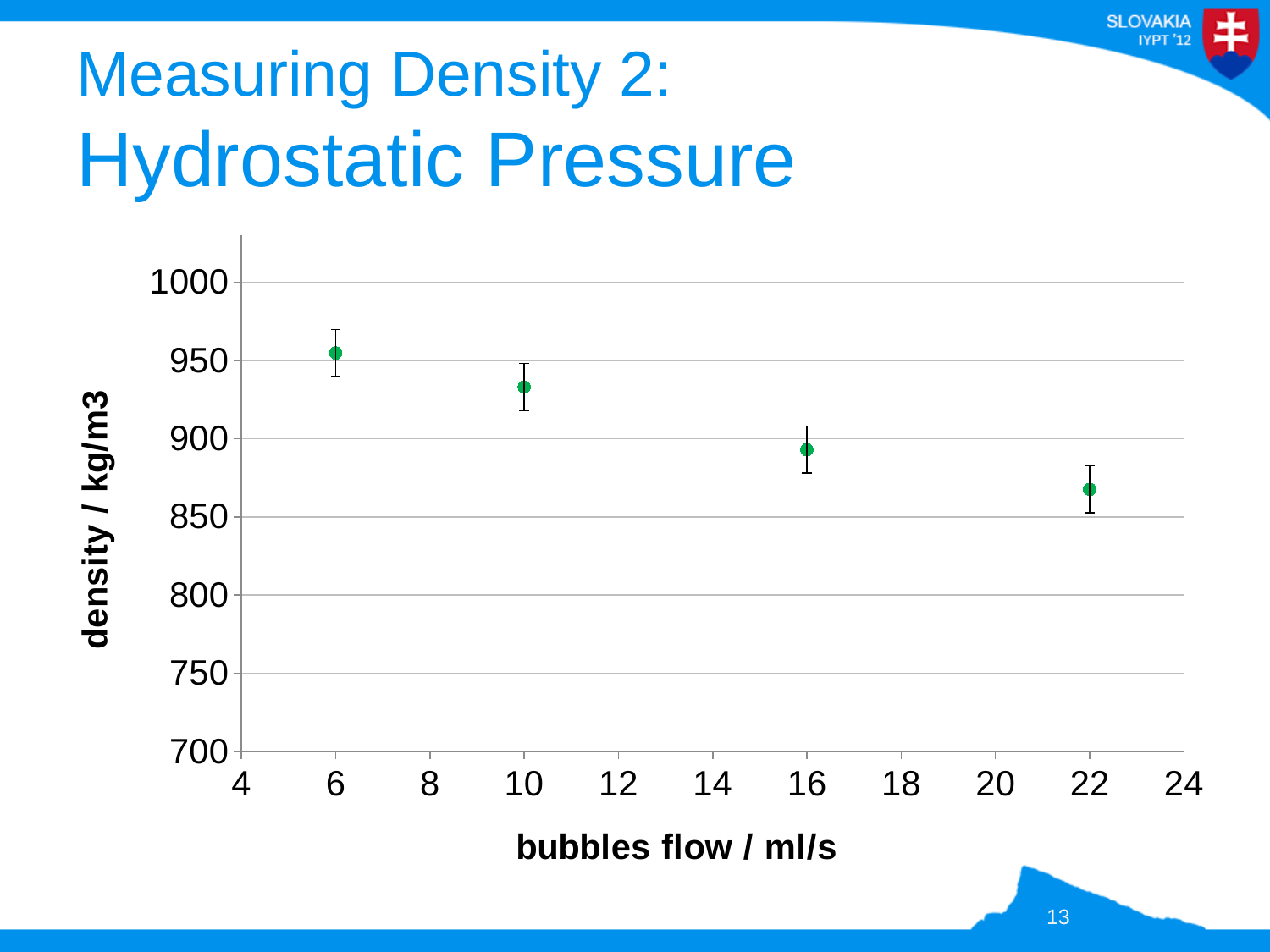
Is the density at a bubbles flow of 6 ml/s greater or less than 900 kg/m3? greater What is the label of the x axis of the chart? bubbles flow / ml/s What kind of chart is shown on the slide? scatter chart Is the density at a bubbles flow of 22 ml/s greater or less than 900 kg/m3? less Is the density at a bubbles flow of 10 ml/s greater or less than 950 kg/m3? less At which bubbles flow value (ml/s) is the plotted density highest? 6 At which bubbles flow value (ml/s) is the plotted density lowest? 22 How many data points are plotted on the chart? 4 Which has the larger density: the point at 6 ml/s or the point at 22 ml/s? 6 ml/s Which has the larger density: the point at 10 ml/s or the point at 16 ml/s? 10 ml/s Does the density rise or fall as the bubbles flow increases along the x axis? fall